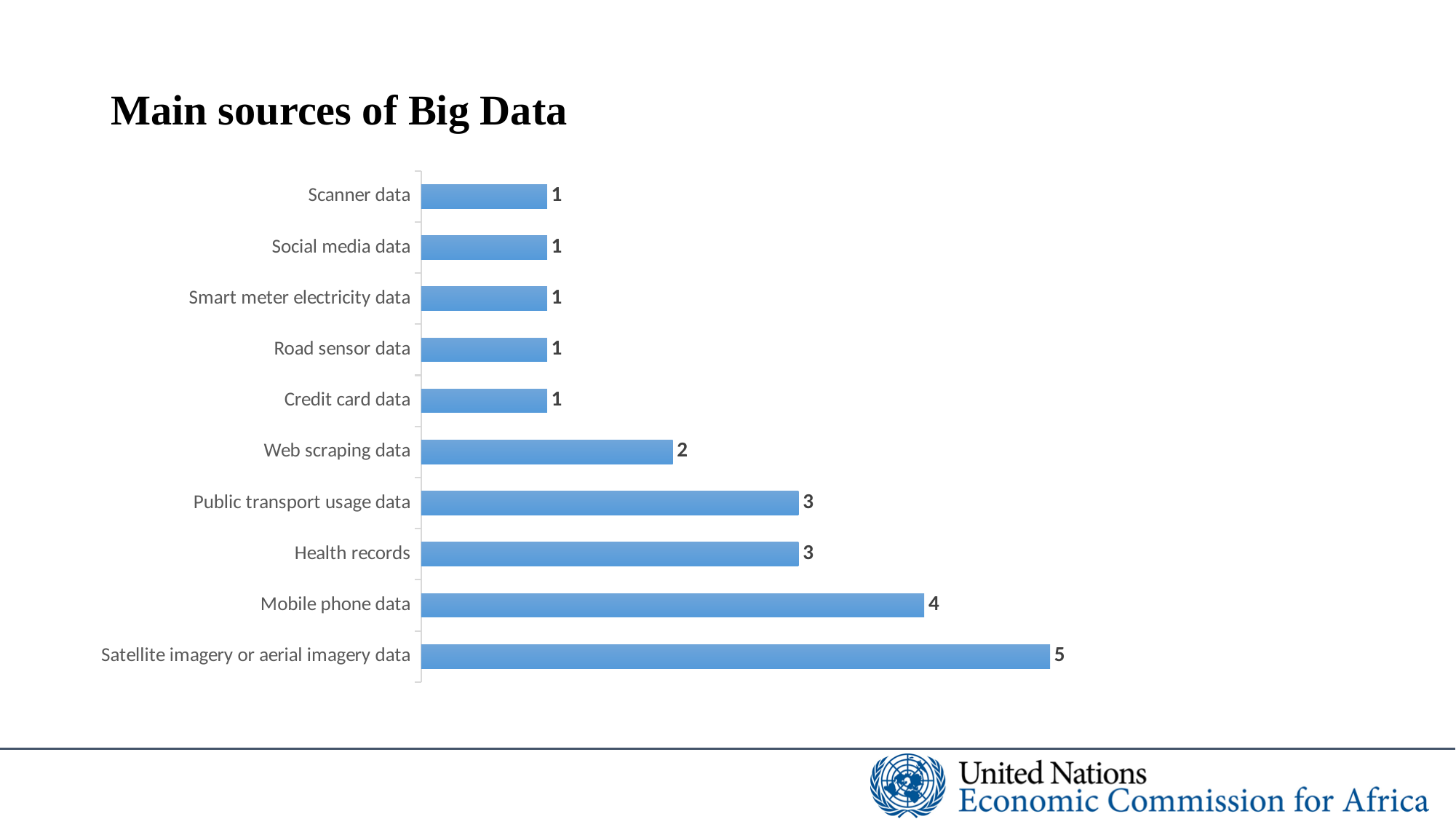
What is the value for Health records? 3 What is the difference between the values for Public transport usage data and Web scraping data? 1 Which is larger, the value for Mobile phone data or the value for Health records? Mobile phone data What is the value for Satellite imagery or aerial imagery data? 5 What is the value for Web scraping data? 2 Which category has the highest value? Satellite imagery or aerial imagery data How many categories are shown in the chart? 10 How many categories have a value of 1? 5 What is the difference between the values for Satellite imagery or aerial imagery data and Mobile phone data? 1 What is the value for Mobile phone data? 4 What kind of chart is shown on the slide? Bar chart What is the title of the slide? Main sources of Big Data